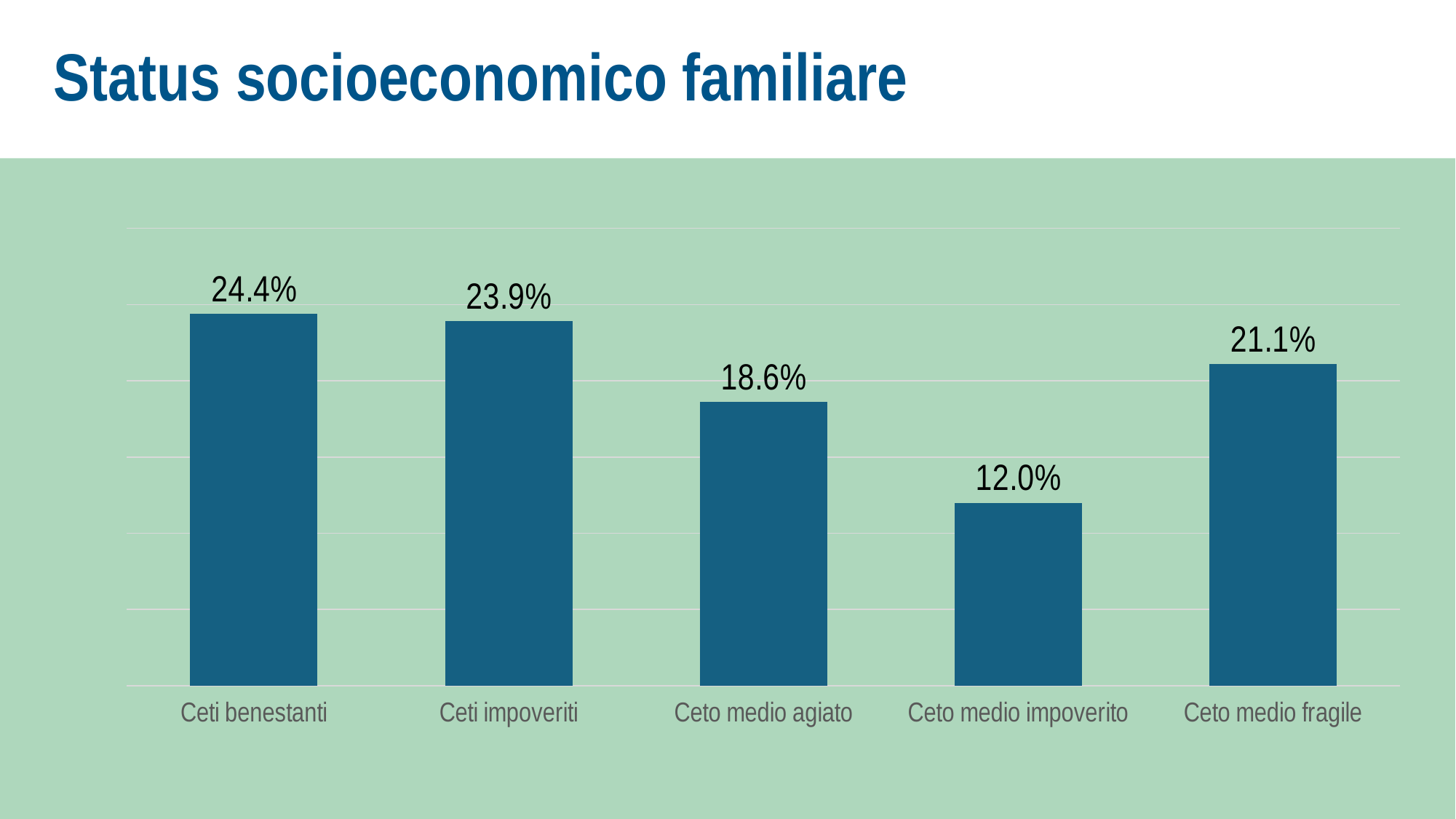
What is the value for Ceto medio impoverito? 12.0% What is the value for Ceti benestanti? 24.4% What is the difference between the values for Ceti benestanti and Ceto medio impoverito? 12.4% Which is larger, the value for Ceto medio agiato or the value for Ceto medio fragile? Ceto medio fragile What is the difference between the values for Ceti impoveriti and Ceto medio fragile? 2.8% What is the value for Ceto medio agiato? 18.6% Which category has the lowest value? Ceto medio impoverito What kind of chart is shown on the slide? Bar chart Which category has the highest value? Ceti benestanti What is the value for Ceto medio fragile? 21.1% How many categories are shown in the chart? 5 What is the title of the slide? Status socioeconomico familiare